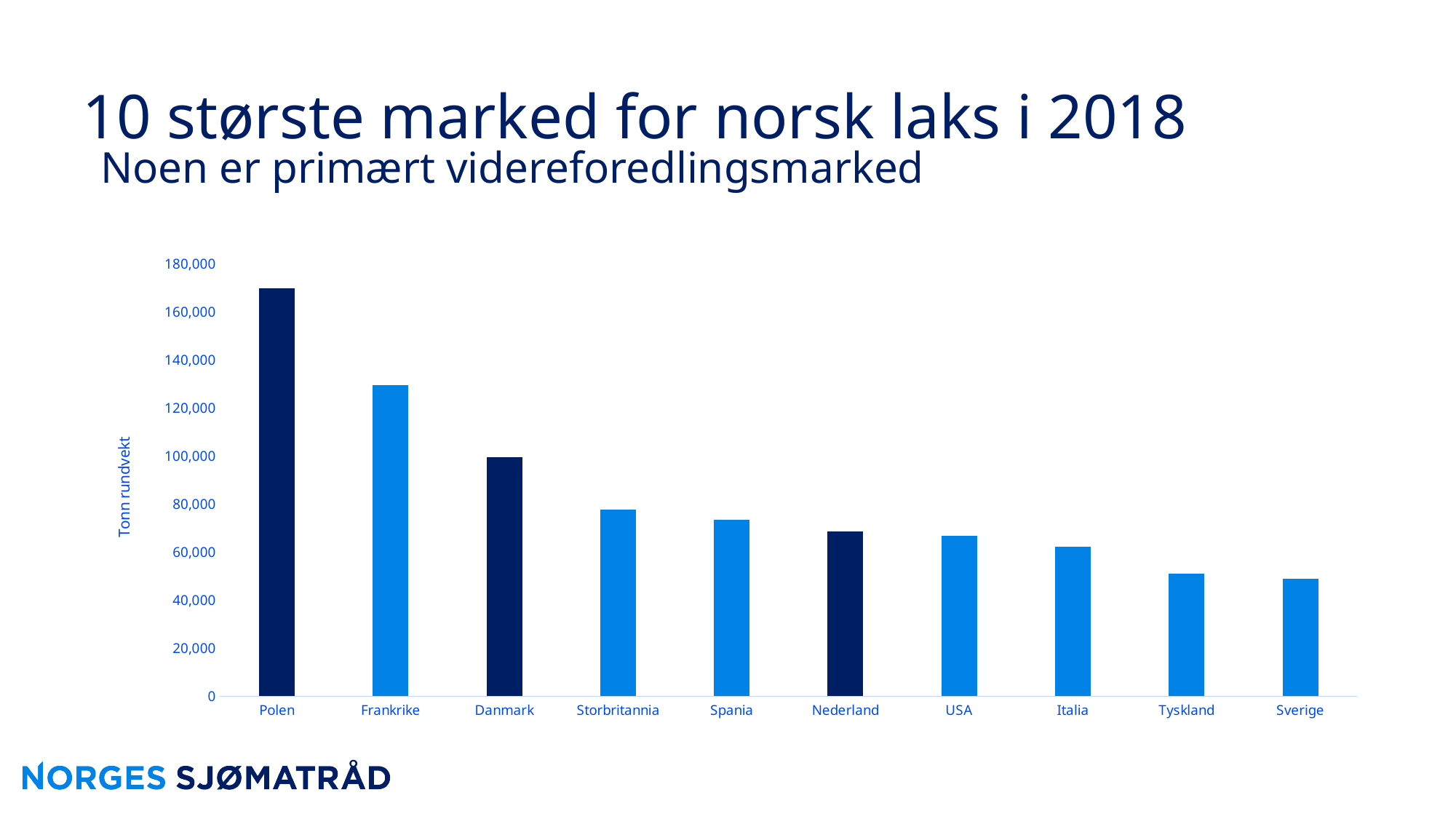
Do the bar values rise or fall from left to right along the x axis? Fall Is the value for Polen greater or less than 160,000? greater Which has a larger value, Frankrike or Danmark? Frankrike Is the value for Sverige greater or less than 60,000? less Is the value for Tyskland greater or less than 40,000? greater Which country has the highest bar in the chart? Polen Which country has the lowest bar in the chart? Sverige How many countries are shown on the x axis of the chart? 10 What kind of chart is shown on the slide? Bar chart What is the label on the vertical axis of the chart? Tonn rundvekt